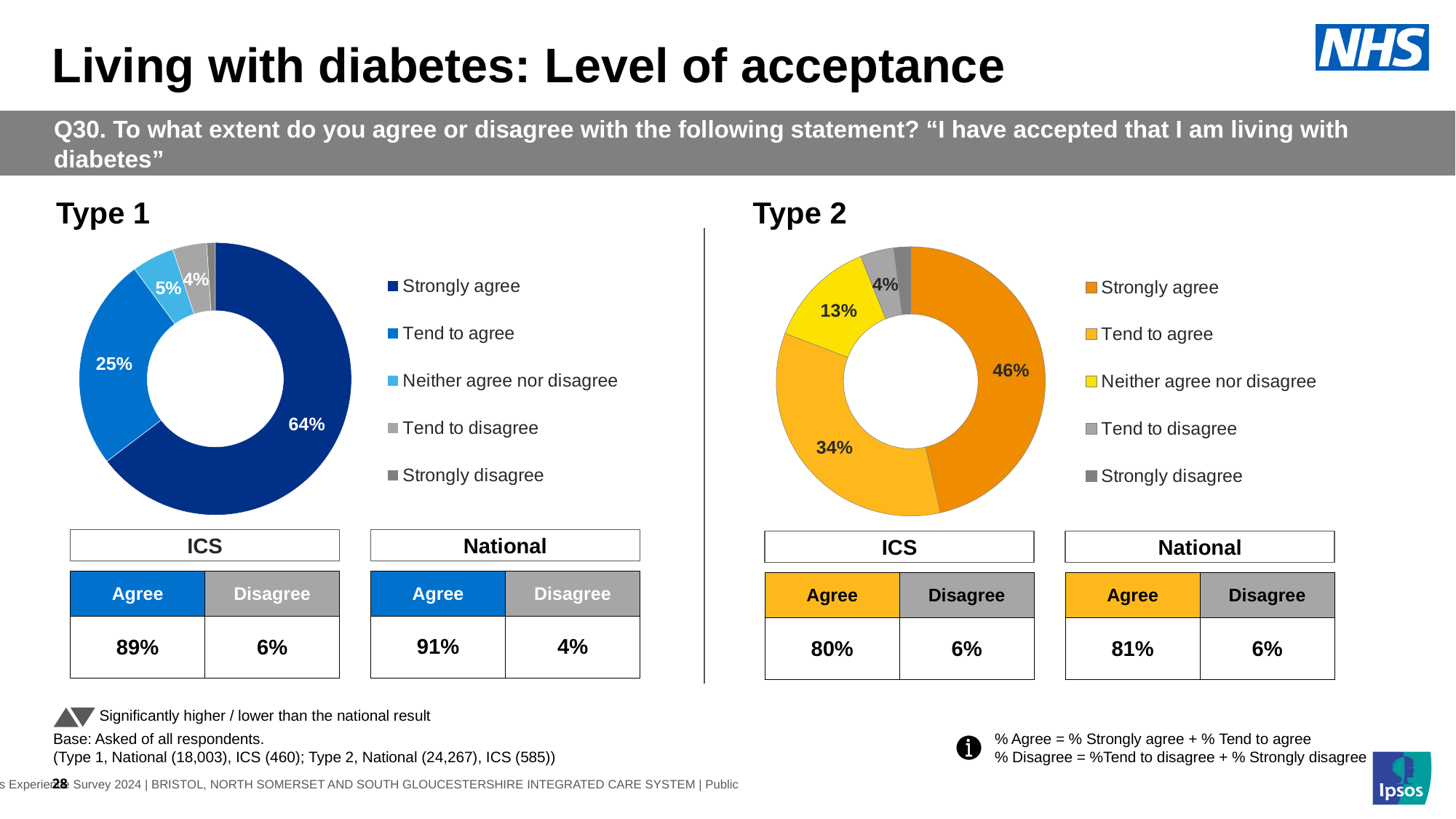
In the Type 2 chart, what percentage of respondents strongly agree? 46% In the Type 2 chart, what percentage of respondents tend to agree? 34% What kind of chart is used for Type 1? Donut (pie) chart In the Type 1 chart, what percentage of respondents tend to agree? 25% In the Type 2 chart, what is the difference in percentage points between Strongly agree and Tend to agree? 12 In the Type 1 chart, what is the difference in percentage points between Strongly agree and Tend to agree? 39 In the Type 2 chart, which response category has the largest share? Strongly agree In the Type 2 chart, what percentage of respondents neither agree nor disagree? 13% How many response categories does the legend of the Type 2 chart list? 5 In the Type 1 chart, which response category has the largest share? Strongly agree Which chart has the larger share for Strongly agree, Type 1 or Type 2? Type 1 In the Type 1 chart, what percentage of respondents strongly agree? 64%